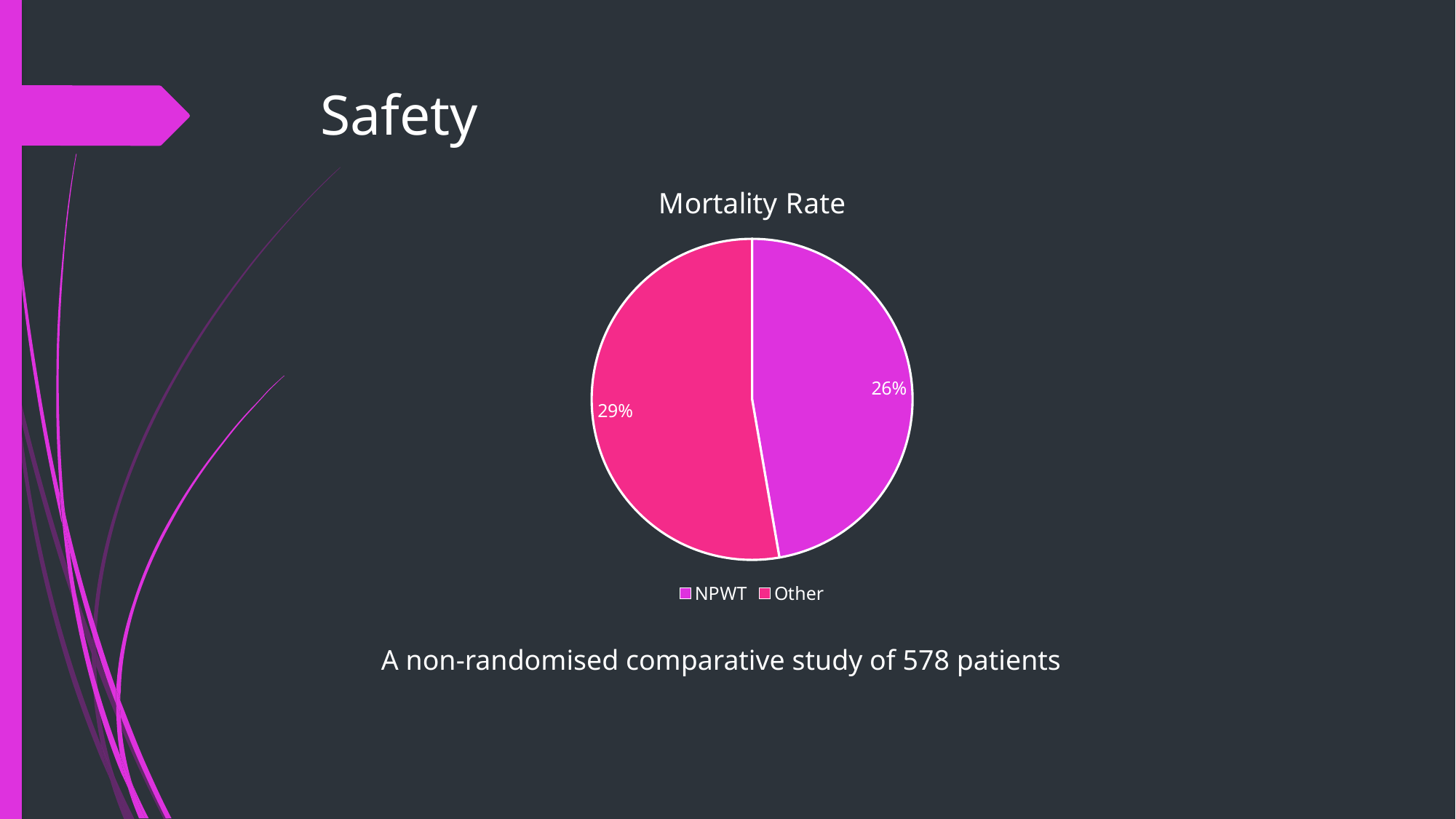
What type of chart is shown on the slide? pie chart What value is labelled on the NPWT slice of the Mortality Rate chart? 26% What is the difference between the labelled values for Other and NPWT? 3% Which legend entry is shown in the pink colour? Other Which category has the lowest labelled value in the Mortality Rate chart? NPWT Which category has the highest labelled value in the Mortality Rate chart? Other How many entries does the legend list? 2 What is the title of the chart? Mortality Rate Which category has the higher labelled mortality rate, NPWT or Other? Other What value is labelled on the Other slice of the Mortality Rate chart? 29% How many slices does the Mortality Rate pie chart have? 2